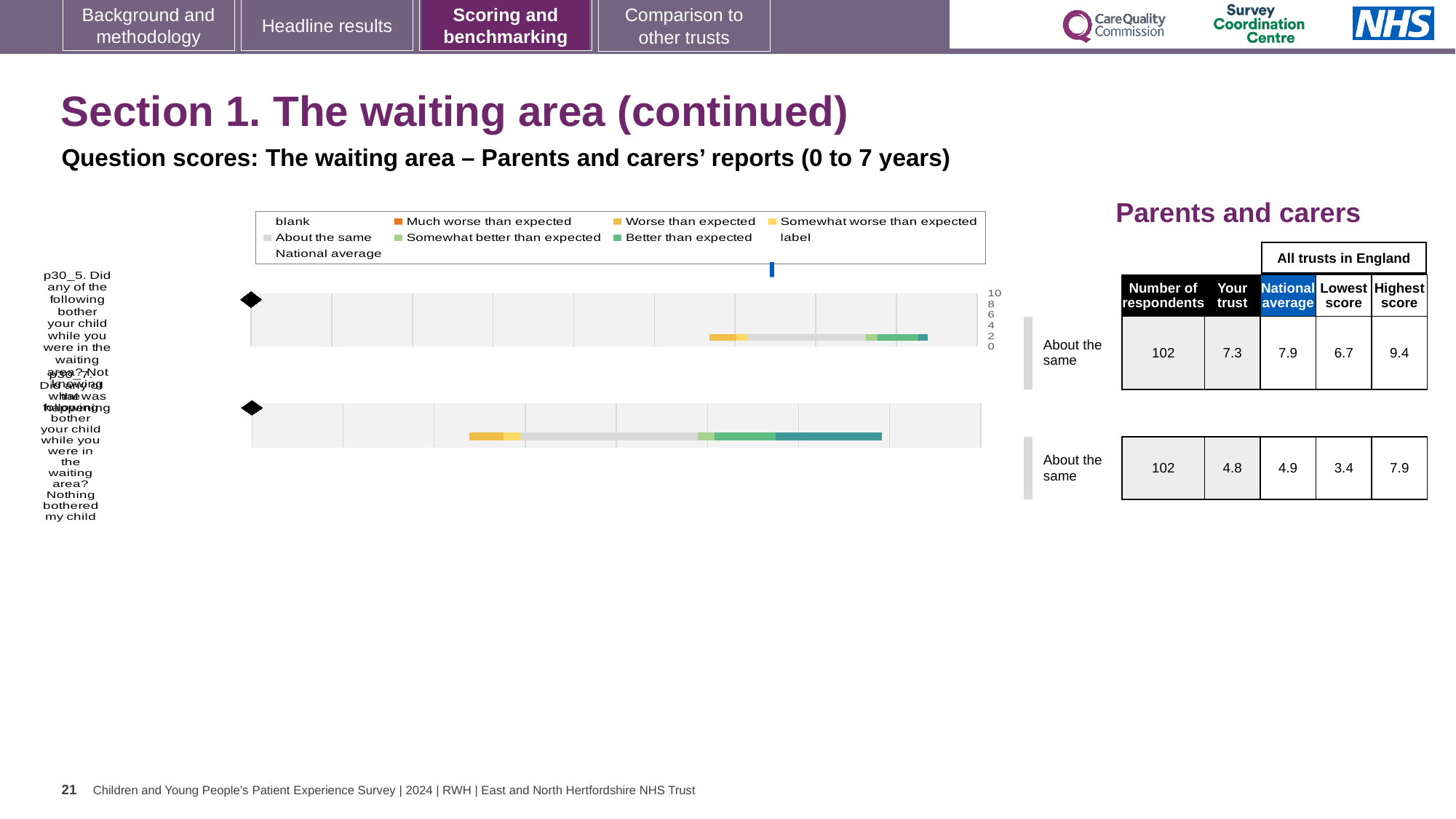
In the table next to the chart, what is the difference between the highest score and the lowest score in the first row? 2.7 How many survey questions (rows) are plotted in the chart area? 2 In the table next to the chart, what is the national average in the first row? 7.9 In the table next to the chart, what is the 'Your trust' score in the first row (p30_5)? 7.3 What benchmark category is shown beside both chart rows? About the same In the chart legend, what colour represents 'Much worse than expected'? orange What kind of chart is used to show the question scores on this slide? bar chart How many entries does the chart legend list? 9 In the table next to the chart, which is larger in the second row: 'Your trust' or 'National average'? National average In the table next to the chart, what is the number of respondents for the second row (p30_7)? 102 In the table next to the chart, what is the lowest score in the second row? 3.4